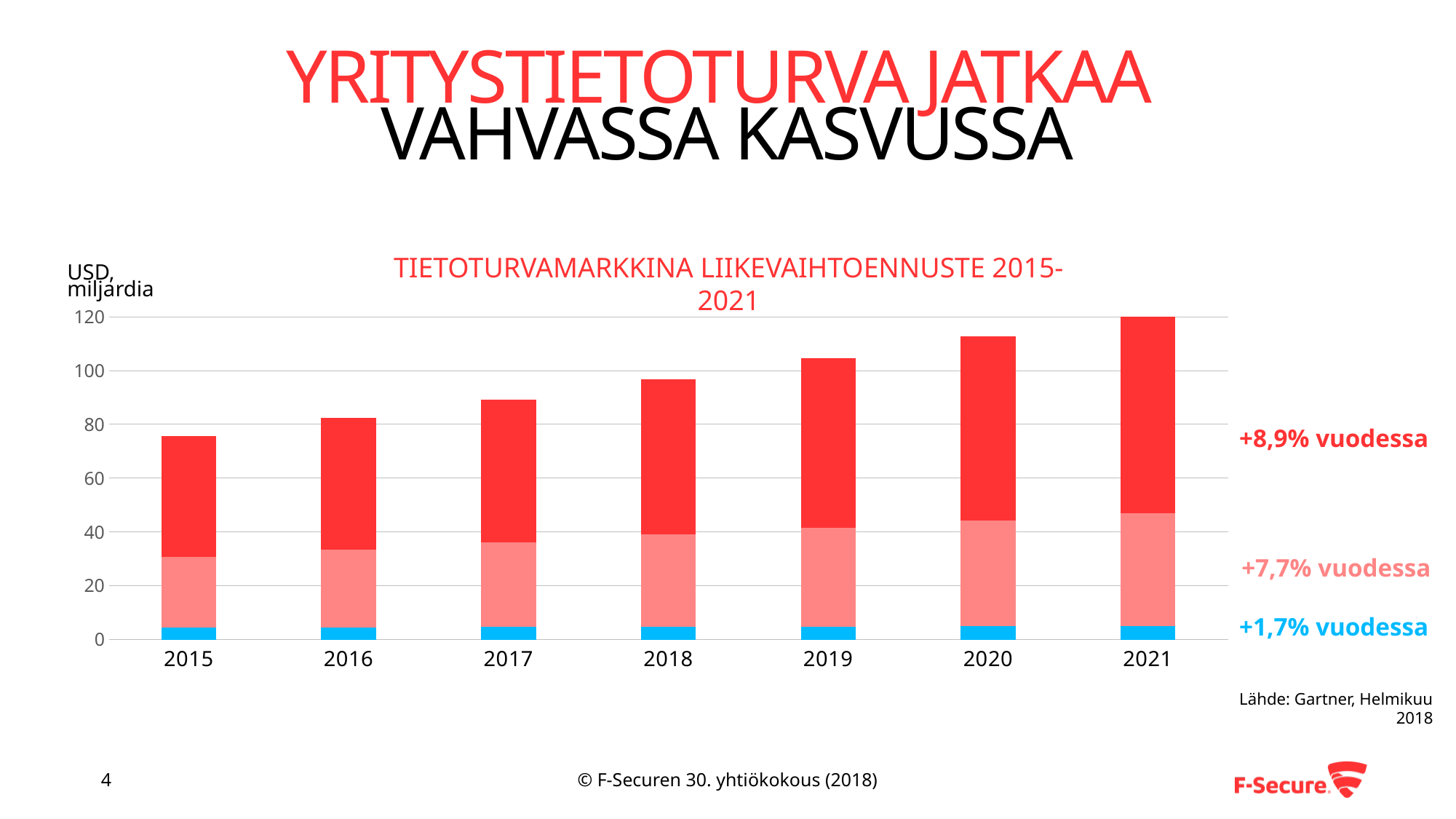
Is the total value for 2017 greater or less than 80? greater Which year has the tallest total bar? 2021 Do the total bar heights rise or fall from 2015 to 2021? rise Which total bar is taller, 2019 or 2016? 2019 What is the title of the chart? TIETOTURVAMARKKINA LIIKEVAIHTOENNUSTE 2015-2021 Is the total value for 2020 greater or less than 100? greater What annual growth rate is annotated next to the top (dark red) segment of the bars? +8,9% vuodessa What kind of chart is shown on the slide? stacked bar chart Is the total value for 2018 greater or less than 100? less How many years are shown on the x axis of the chart? 7 Which year has the shortest total bar? 2015